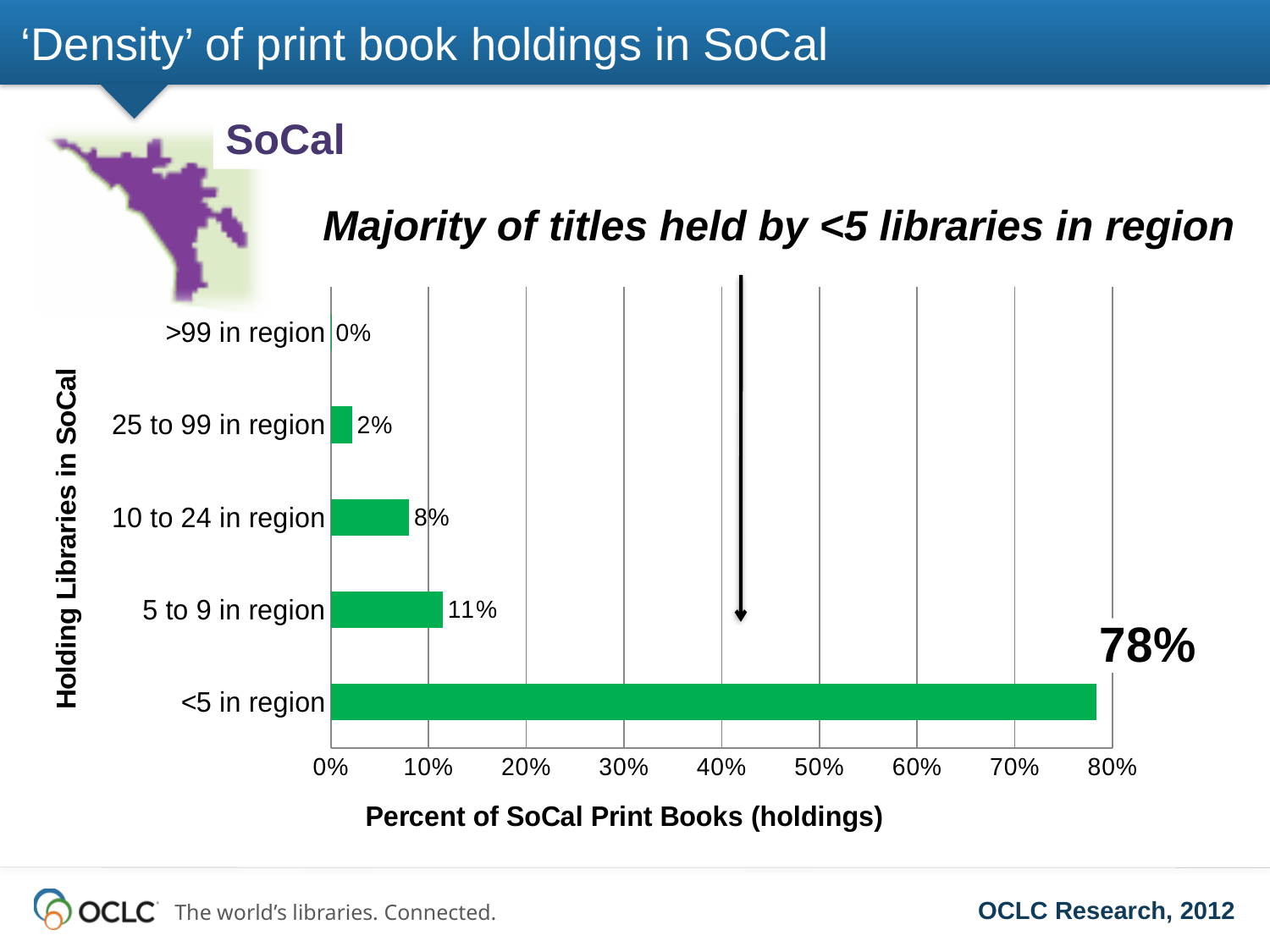
Which is larger, the value for '10 to 24 in region' or '25 to 99 in region'? 10 to 24 in region How many categories are shown on the chart? 5 Which category has the highest percent of SoCal print book holdings? <5 in region Which category has the lowest percent of SoCal print book holdings? >99 in region What is the label of the horizontal axis of the chart? Percent of SoCal Print Books (holdings) What is the value for the '10 to 24 in region' category? 8% What is the value for the '>99 in region' category? 0% What percent of SoCal print book holdings are for titles held by <5 libraries in the region? 78% What is the value for the '5 to 9 in region' category? 11% What kind of chart is shown on the slide? Bar chart What is the value for the '25 to 99 in region' category? 2% What is the difference between the values for '<5 in region' and '5 to 9 in region'? 67%